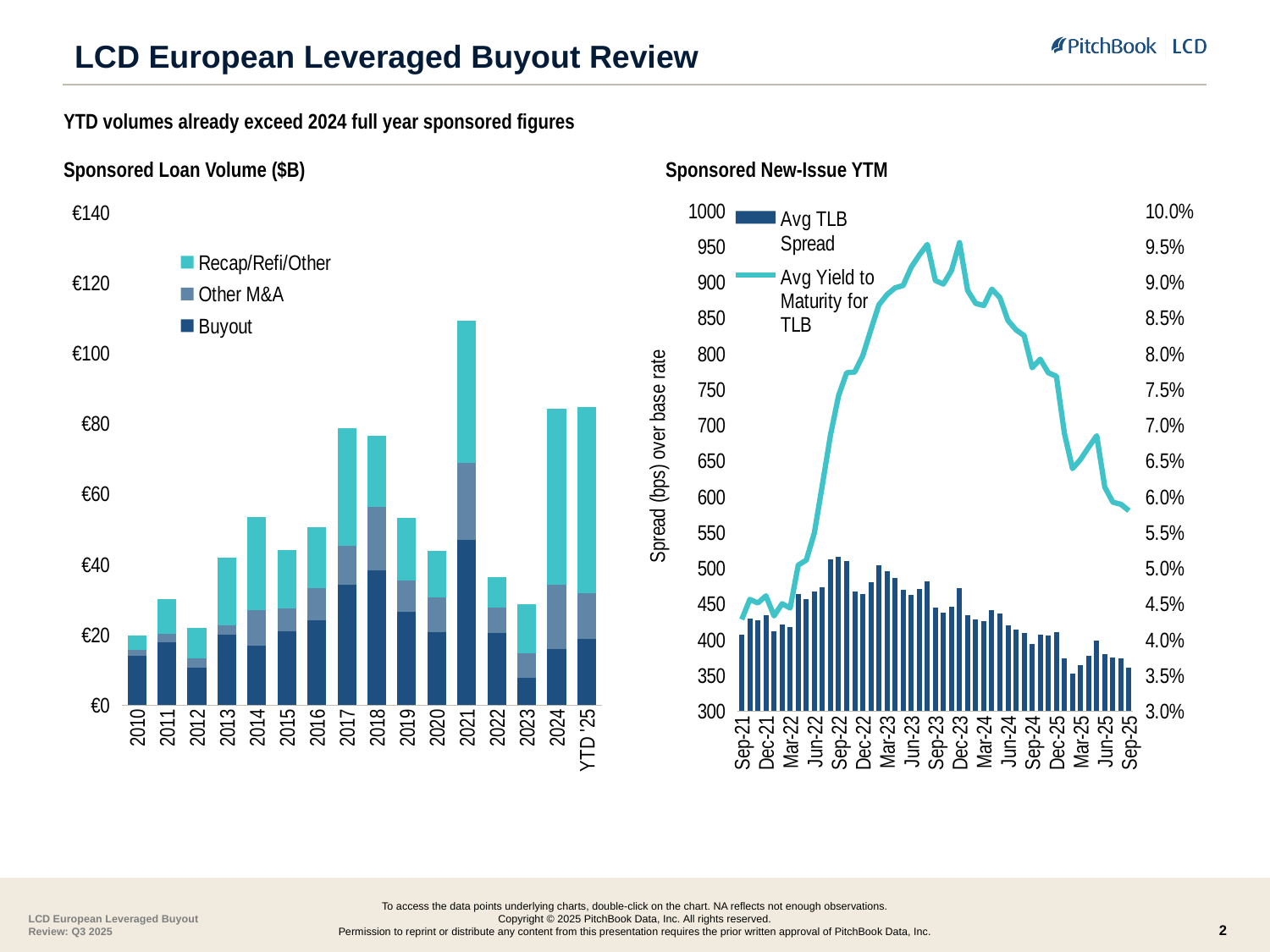
In the Sponsored Loan Volume ($B) chart, which year has the highest total sponsored loan volume? 2021 In the Sponsored New-Issue YTM chart, is the Avg Yield to Maturity for TLB at Sep-21 greater or less than 5.0%? less In the Sponsored Loan Volume ($B) chart, which series is shown at the bottom of each stacked bar? Buyout In the Sponsored Loan Volume ($B) chart, is the total bar for 2021 greater or less than €100? greater In the Sponsored Loan Volume ($B) chart, how many series does the legend list? 3 In the Sponsored New-Issue YTM chart, does the Avg Yield to Maturity for TLB line rise or fall from Dec-23 to Sep-25? Fall What kind of chart is the Sponsored Loan Volume ($B) chart? Stacked bar chart In the Sponsored New-Issue YTM chart, how many series does the legend list? 2 In the Sponsored Loan Volume ($B) chart, which total bar is larger, 2018 or 2019? 2018 In the Sponsored Loan Volume ($B) chart, is the total bar for 2010 greater or less than €40? less In the Sponsored New-Issue YTM chart, what is the label on the left vertical axis? Spread (bps) over base rate In the Sponsored Loan Volume ($B) chart, how many categories are shown on the x axis? 16